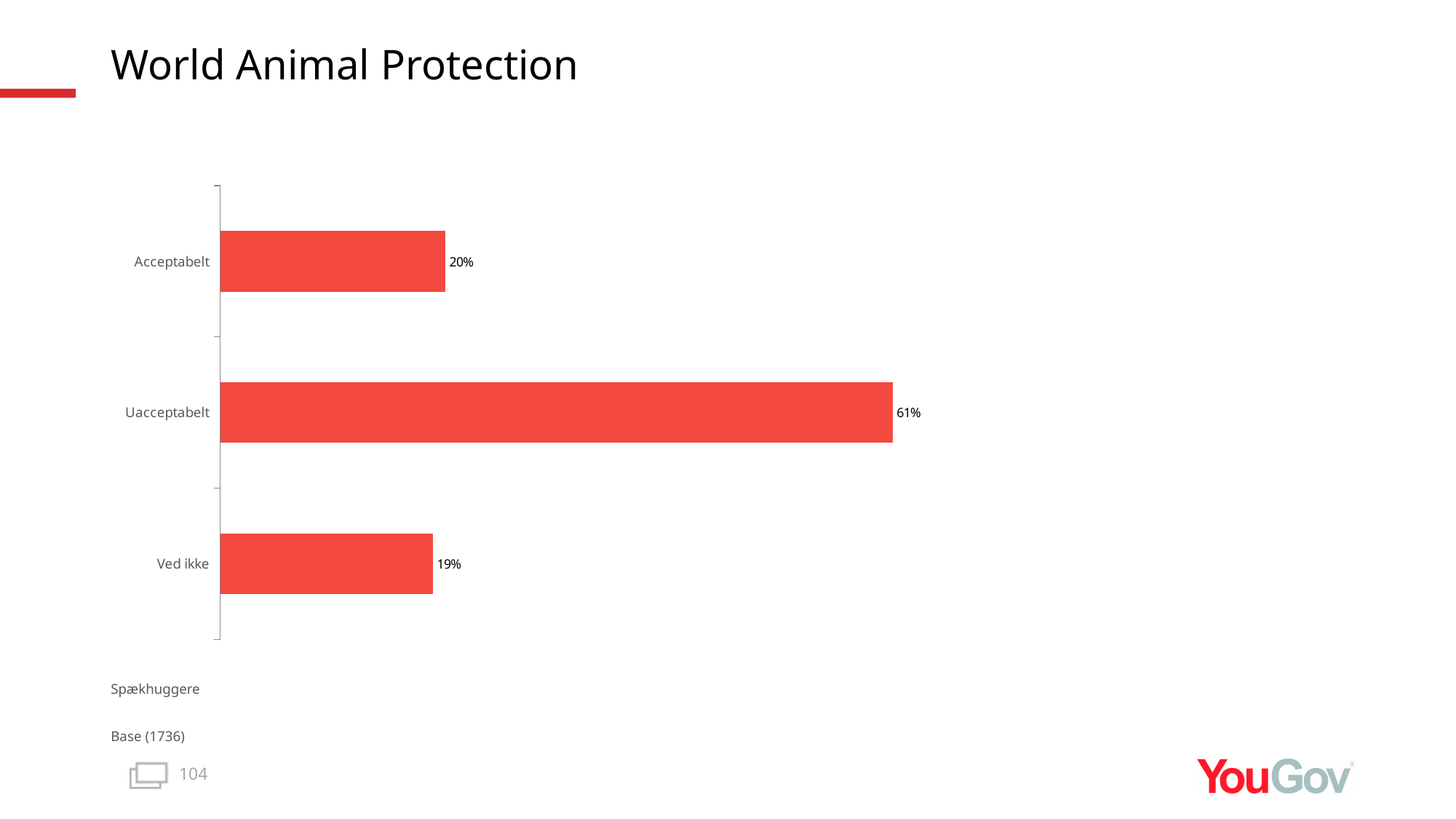
How many categories are shown in the chart? 3 What is the difference between the values for Uacceptabelt and Acceptabelt? 41% What base size is stated below the chart? 1736 What is the title of the slide? World Animal Protection What is the difference between the values for Acceptabelt and Ved ikke? 1% What kind of chart is shown on the slide? Bar chart Which category has the highest value? Uacceptabelt Which category has the lowest value? Ved ikke What is the value for Ved ikke? 19% What is the value for Uacceptabelt? 61% Which is larger, the value for Uacceptabelt or the value for Ved ikke? Uacceptabelt What is the value for Acceptabelt? 20%